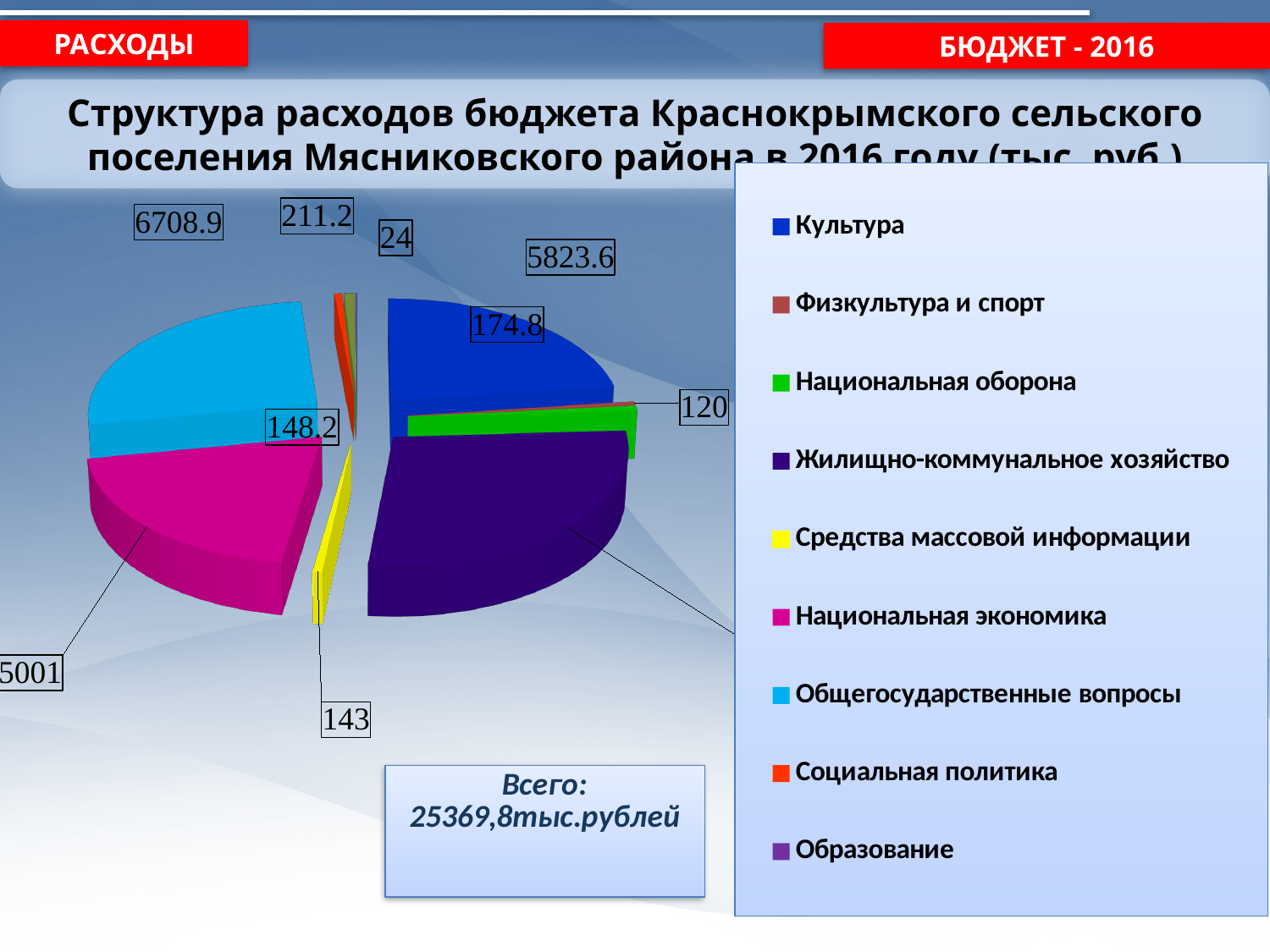
How many categories does the legend of the pie chart list? 9 What is the difference between the values for Национальная экономика and Средства массовой информации? 4858 What total expenditure is stated on the slide? 25369,8 тыс. рублей Which is larger, Национальная экономика or Национальная оборона? Национальная экономика What is the value shown for Общегосударственные вопросы? 6708.9 What kind of chart is shown on the slide? pie chart What is the smallest data label shown on the pie chart? 24 What is the value shown for Национальная оборона? 174.8 What is the value shown for Национальная экономика? 5001 What colour represents Культура in the legend? blue What is the value shown for Средства массовой информации? 143 What is the value shown for Культура? 5823.6